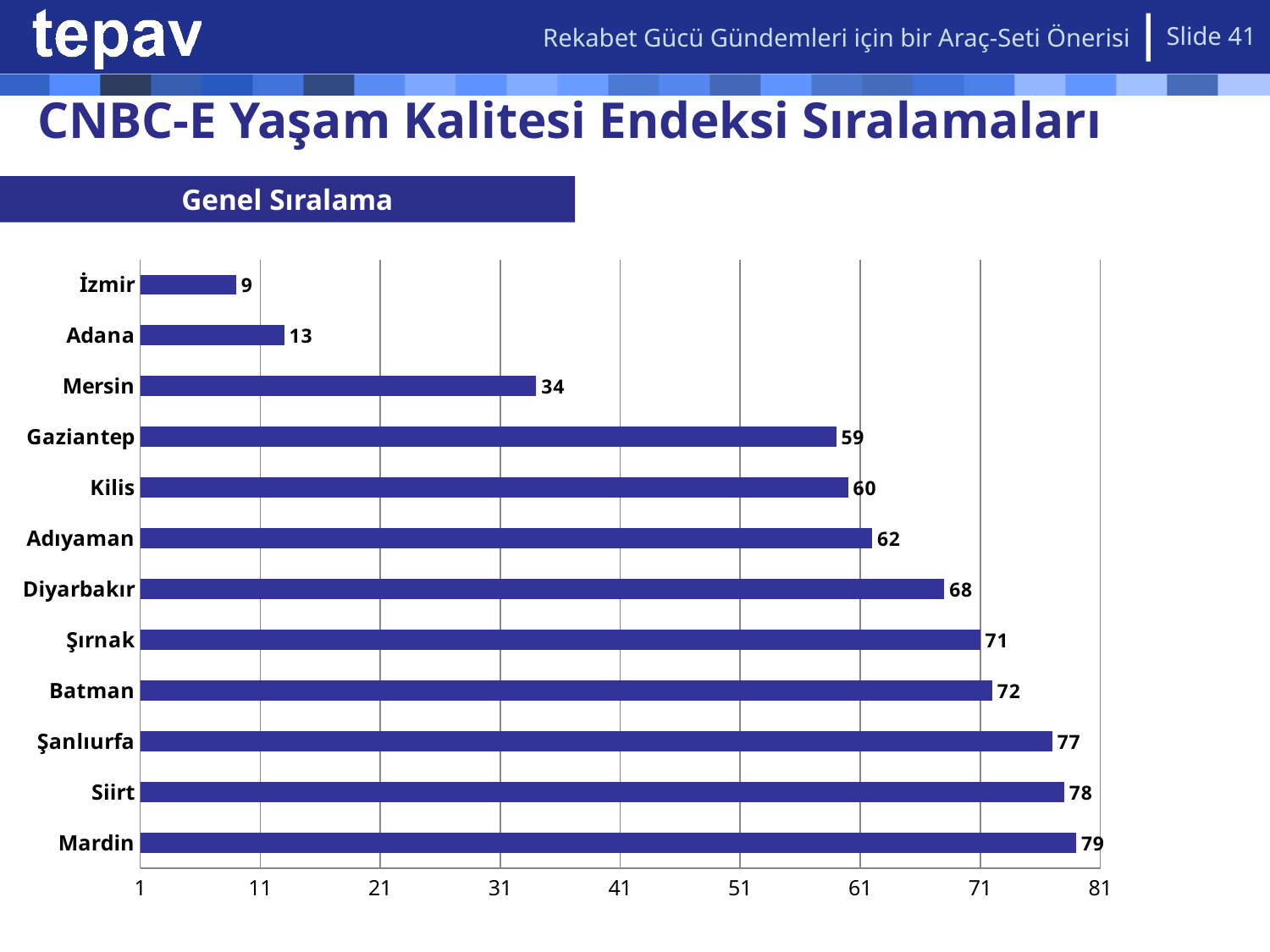
What is the value for Mersin? 34 How many cities are shown in the chart? 12 Is the value for Adıyaman greater or less than 51? greater What is the value for Şanlıurfa? 77 Do the values increase or decrease going from İzmir at the top to Mardin at the bottom? increase What is the label shown in the blue box above the chart? Genel Sıralama What is the difference between the values for Gaziantep and Adana? 46 Which has a larger value, Kilis or Batman? Batman Which city has the lowest value? İzmir What kind of chart is shown on the slide? bar chart Which city has the highest value? Mardin What is the value for Diyarbakır? 68